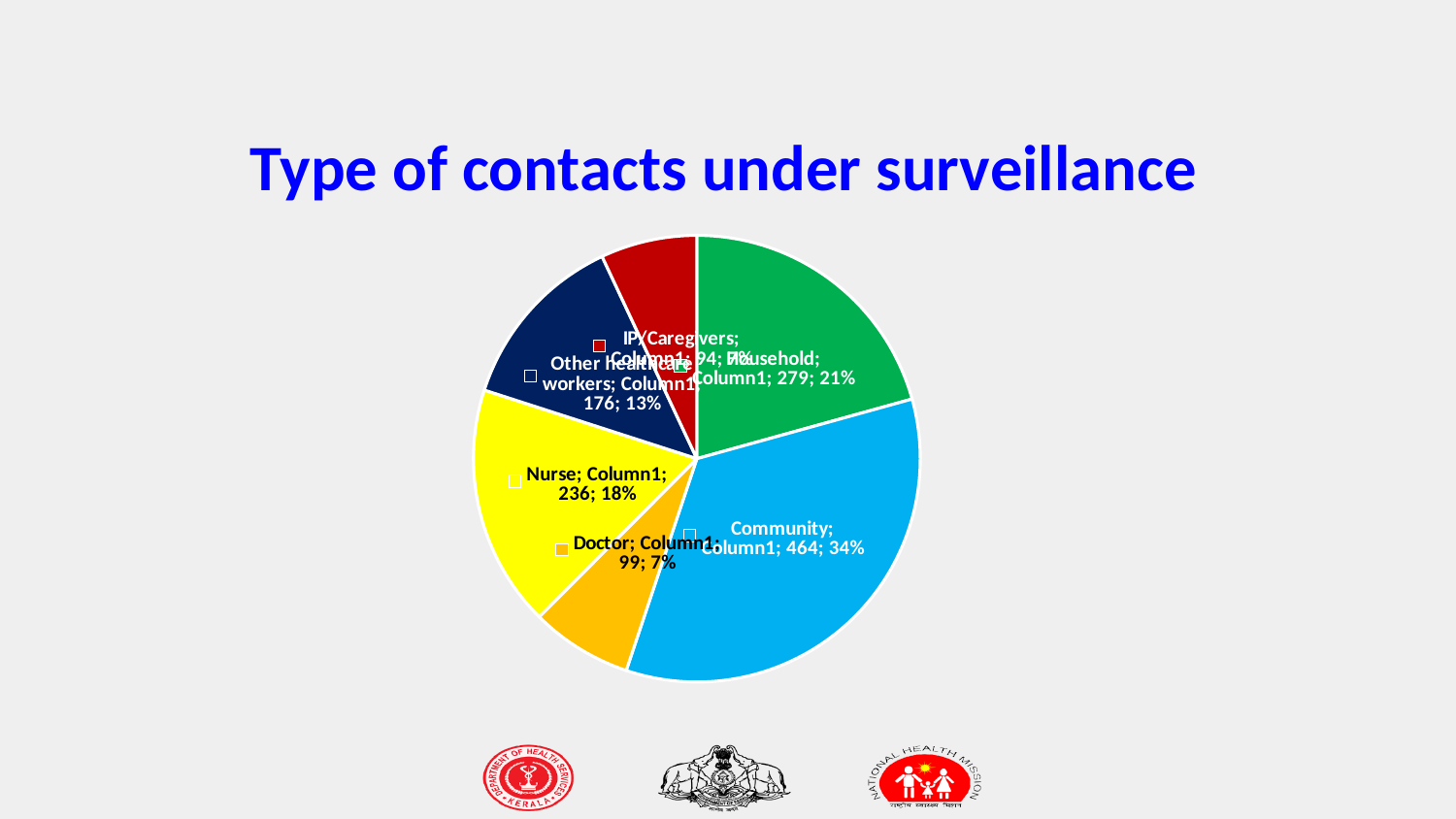
How many slices does the pie chart have? 6 What is the value for Community? 464 Which category has the smallest value? IP/Caregivers What kind of chart is shown on the slide? pie chart Which category has the largest slice? Community What is the title of the chart? Type of contacts under surveillance What is the value for Doctor? 99 What share of the pie does Nurse represent? 18% What is the difference between the values for Community and Household? 185 Which is larger, the value for Nurse or the value for Other healthcare workers? Nurse What is the value for Household? 279 What share of the pie does Community represent? 34%